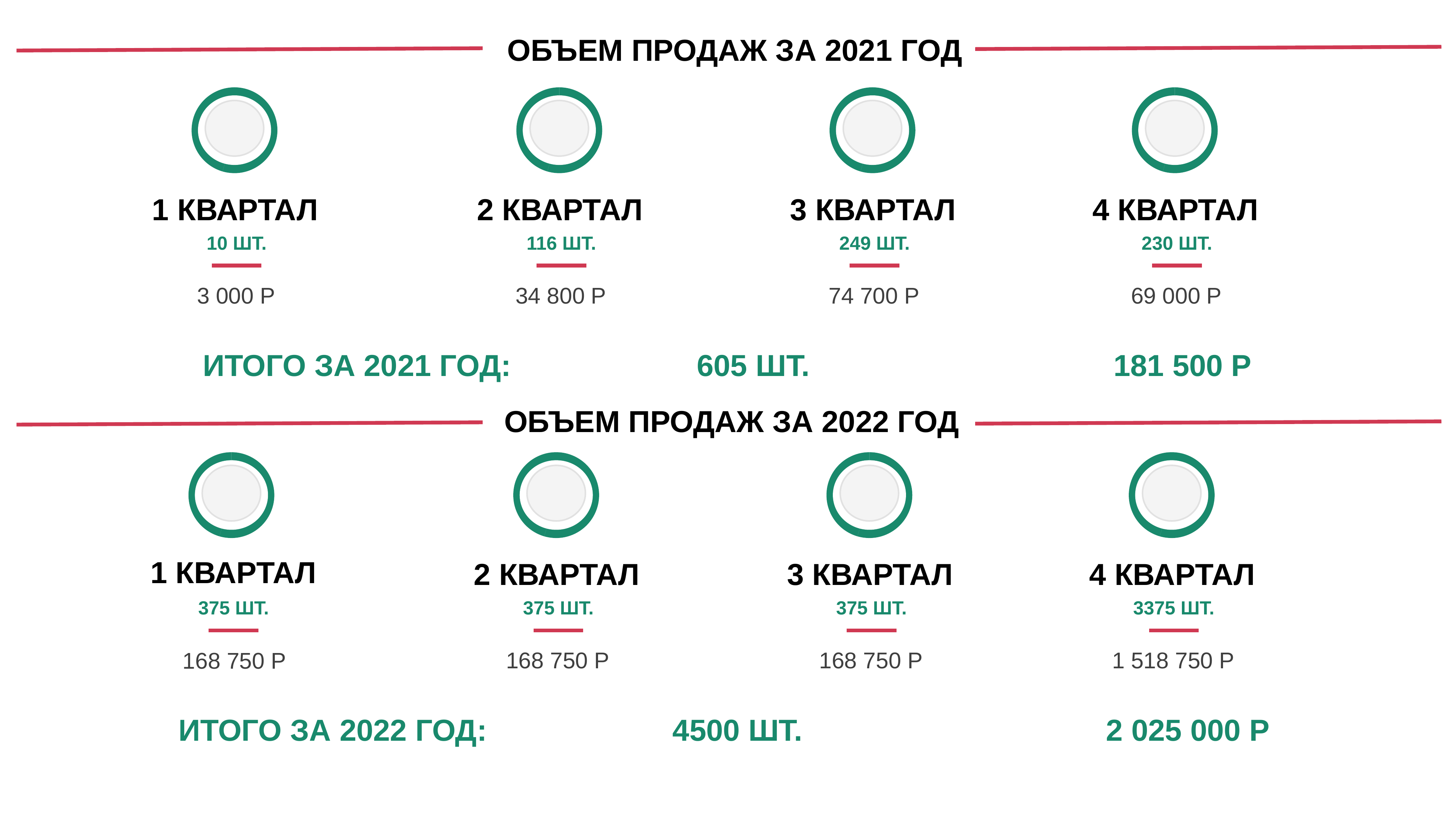
How many quarters are shown in the 'ОБЪЕМ ПРОДАЖ ЗА 2022 ГОД' section? 4 In the 'ОБЪЕМ ПРОДАЖ ЗА 2021 ГОД' section, how many more units were sold in 3 КВАРТАЛ than in 4 КВАРТАЛ? 19 ШТ. In the 'ОБЪЕМ ПРОДАЖ ЗА 2021 ГОД' section, what is the revenue for 3 КВАРТАЛ? 74 700 Р In the 'ОБЪЕМ ПРОДАЖ ЗА 2021 ГОД' section, which quarter has the lowest revenue? 1 КВАРТАЛ In the 'ОБЪЕМ ПРОДАЖ ЗА 2022 ГОД' section, how many units were sold in 4 КВАРТАЛ? 3375 ШТ. In the 'ОБЪЕМ ПРОДАЖ ЗА 2021 ГОД' section, how many units were sold in 1 КВАРТАЛ? 10 ШТ. In the 'ОБЪЕМ ПРОДАЖ ЗА 2022 ГОД' section, how many more units were sold in 4 КВАРТАЛ than in 1 КВАРТАЛ? 3000 ШТ. In the 'ОБЪЕМ ПРОДАЖ ЗА 2021 ГОД' section, what is the total number of units for the year (ИТОГО ЗА 2021 ГОД)? 605 ШТ. In the 'ОБЪЕМ ПРОДАЖ ЗА 2022 ГОД' section, what is the revenue for 1 КВАРТАЛ? 168 750 Р In the 'ОБЪЕМ ПРОДАЖ ЗА 2021 ГОД' section, which has the larger revenue, 2 КВАРТАЛ or 4 КВАРТАЛ? 4 КВАРТАЛ In the 'ОБЪЕМ ПРОДАЖ ЗА 2021 ГОД' section, which quarter has the highest number of units sold? 3 КВАРТАЛ In the 'ОБЪЕМ ПРОДАЖ ЗА 2022 ГОД' section, what is the total revenue for the year (ИТОГО ЗА 2022 ГОД)? 2 025 000 Р